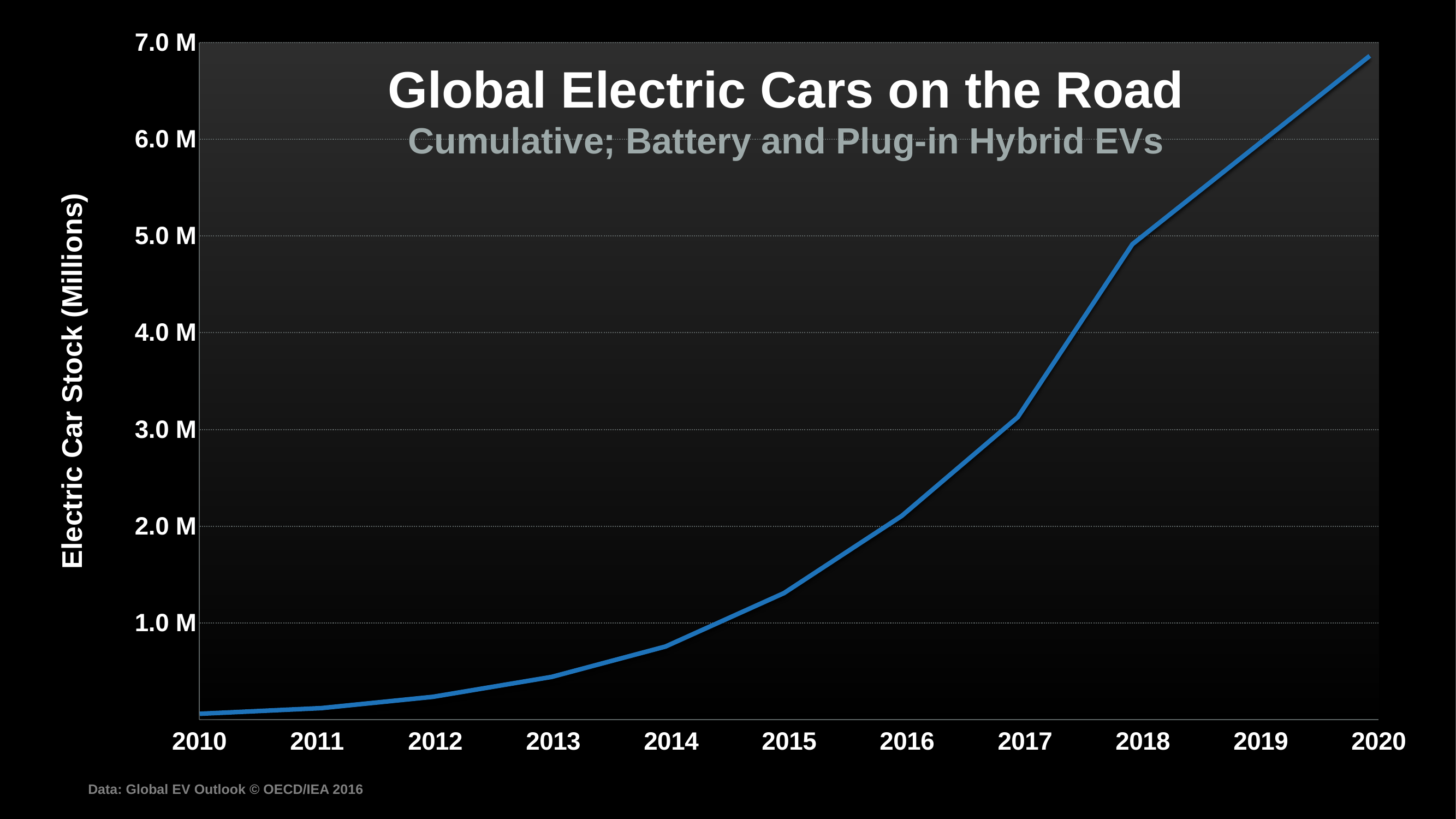
What kind of chart is shown on the slide? line chart Which year has the lowest electric car stock on the chart? 2010 Which year has the highest electric car stock on the chart? 2020 What is the label on the vertical axis of the chart? Electric Car Stock (Millions) How many years are labelled along the x axis of the chart? 11 Is the value for 2020 greater or less than 6.0 M? greater Which year has the larger electric car stock, 2016 or 2018? 2018 Is the value for 2015 greater or less than 1.0 M? greater What is the title of the chart? Global Electric Cars on the Road Is the value for 2017 greater or less than 4.0 M? less Do the values on the chart rise or fall from 2010 to 2020? rise